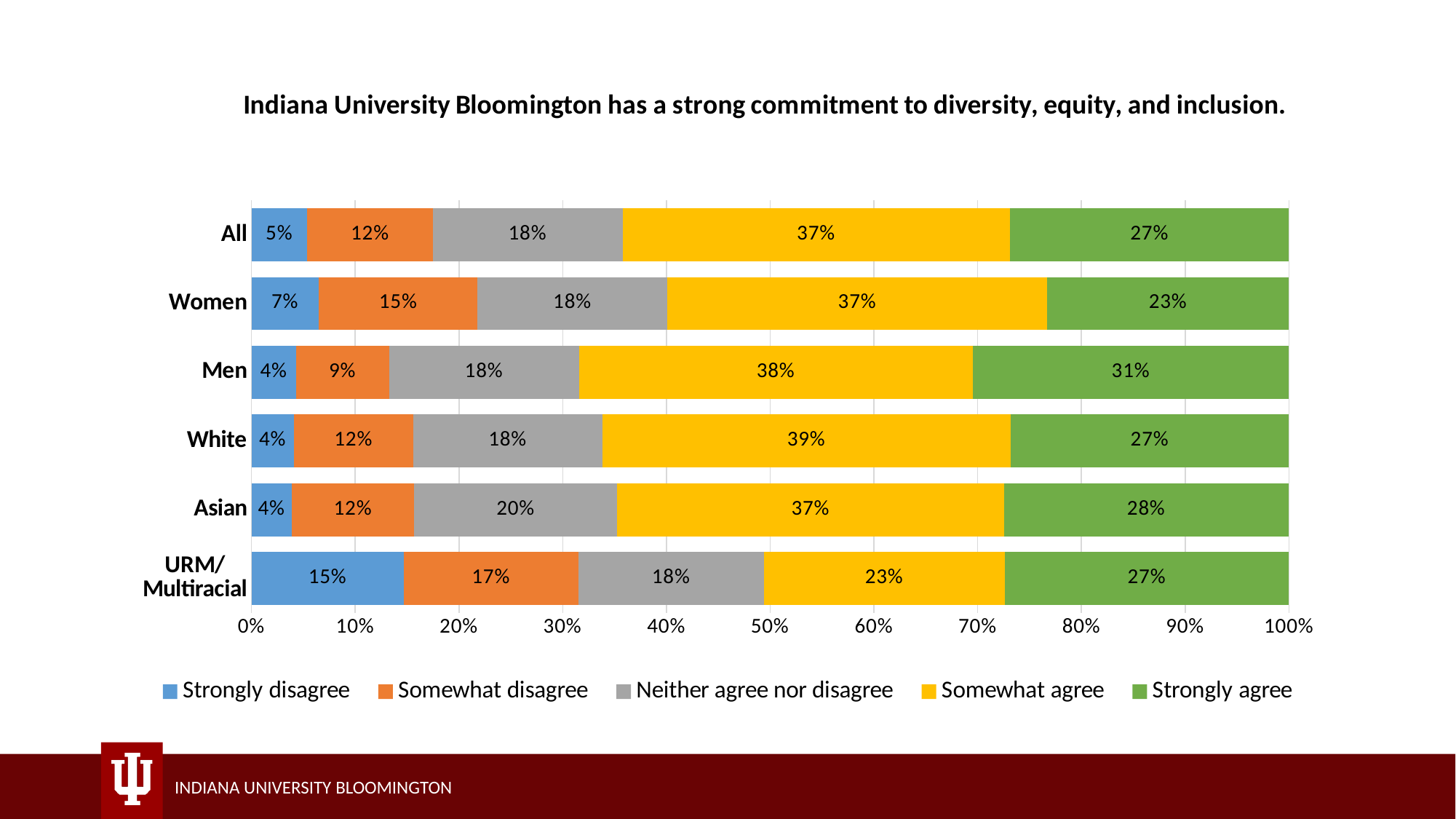
What kind of chart is shown on the slide? Stacked bar chart What is the difference between the Strongly disagree percentage for URM/Multiracial and for All? 10% Which is larger: the Somewhat disagree percentage for Women or for Men? Women What percentage of URM/Multiracial respondents strongly disagree? 15% How many series does the legend list? 5 What is the combined percentage of Somewhat agree and Strongly agree for the All group? 64% What percentage of Men strongly agree? 31% What percentage of Women respondents somewhat agree that Indiana University Bloomington has a strong commitment to diversity, equity, and inclusion? 37% How many groups (categories) are shown on the y axis? 6 Which legend entry is shown in green? Strongly agree Which group has the lowest Somewhat agree percentage? URM/Multiracial Which group has the highest Strongly agree percentage? Men